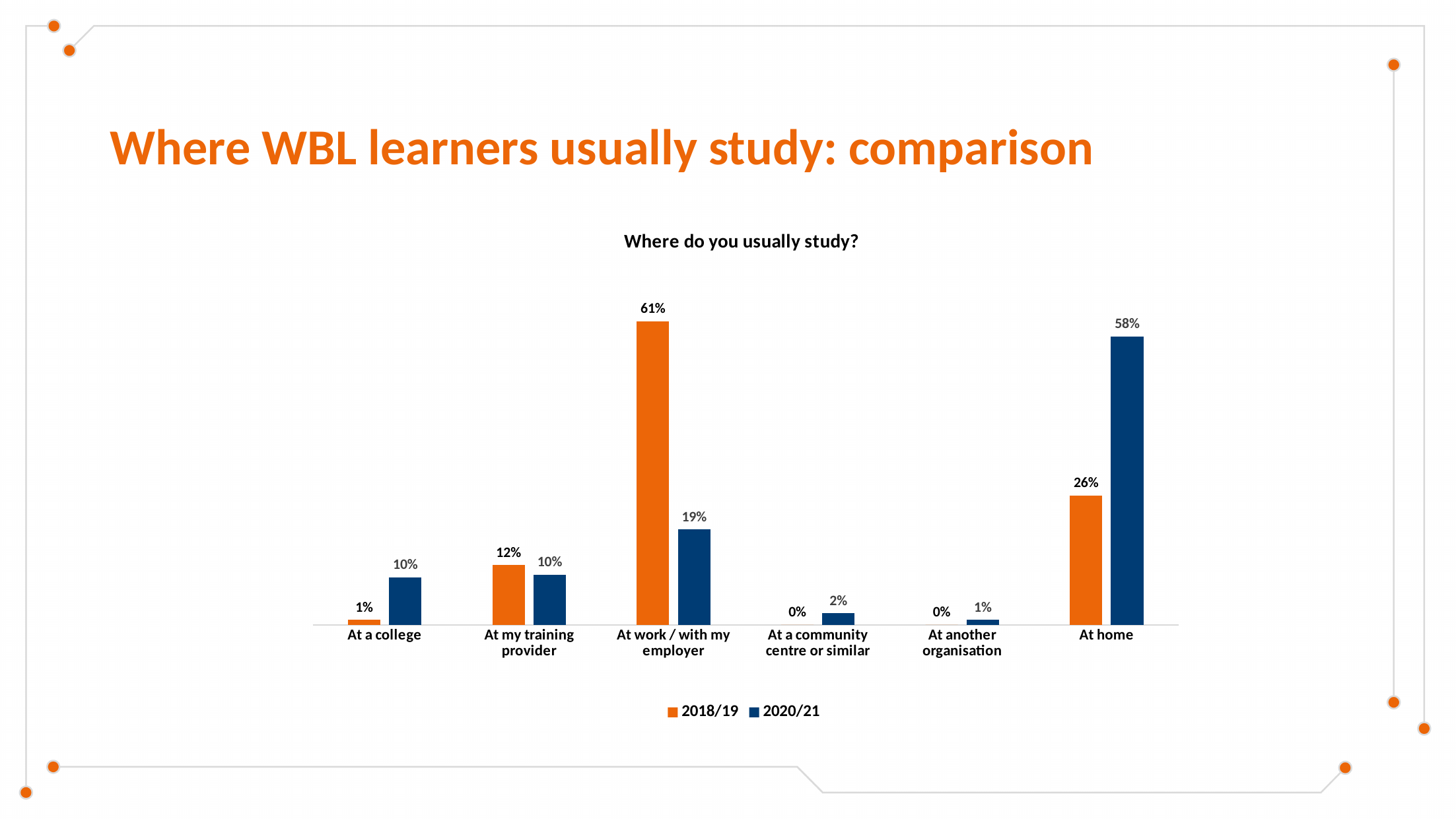
How many categories are shown on the x axis? 6 What percentage of learners said they usually study at home in 2020/21? 58% What percentage of learners said they usually study at work / with my employer in 2018/19? 61% What is the title of the chart? Where do you usually study? What is the difference between the 2020/21 and 2018/19 values for 'At home'? 32% Which category has the highest value for the 2020/21 series? At home For 'At my training provider', which series has the larger value, 2018/19 or 2020/21? 2018/19 Which category has the highest value for the 2018/19 series? At work / with my employer What is the difference between the 2018/19 and 2020/21 values for 'At work / with my employer'? 42% What is the 2020/21 value for 'At a college'? 10% How many series does the legend list? 2 What kind of chart is shown on the slide? Bar chart